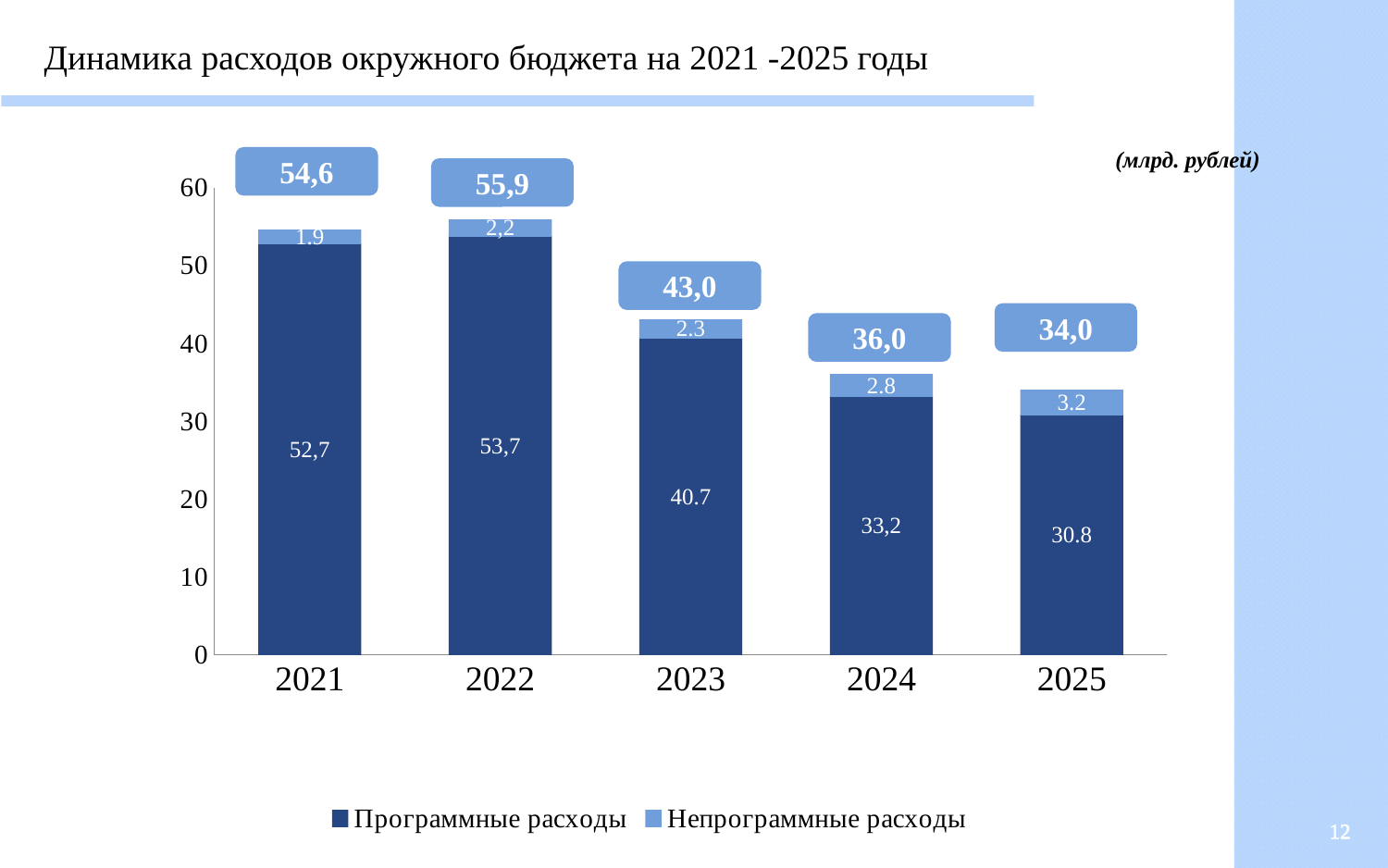
What is the value of Программные расходы for 2021? 52,7 What is the total of the stacked bar for 2023? 43,0 What is the value of Непрограммные расходы for 2025? 3.2 Is the value of Программные расходы for 2022 greater or less than 50? greater How many years are shown on the x axis? 5 Do the values of Непрограммные расходы rise or fall from 2021 to 2025? rise Which year has the larger value of Программные расходы, 2023 or 2024? 2023 What kind of chart is shown on the slide? stacked bar chart Which year has the highest total expenditure? 2022 Which year has the lowest total expenditure? 2025 How many series does the legend list? 2 What is the difference between Непрограммные расходы in 2025 and in 2021? 1.3